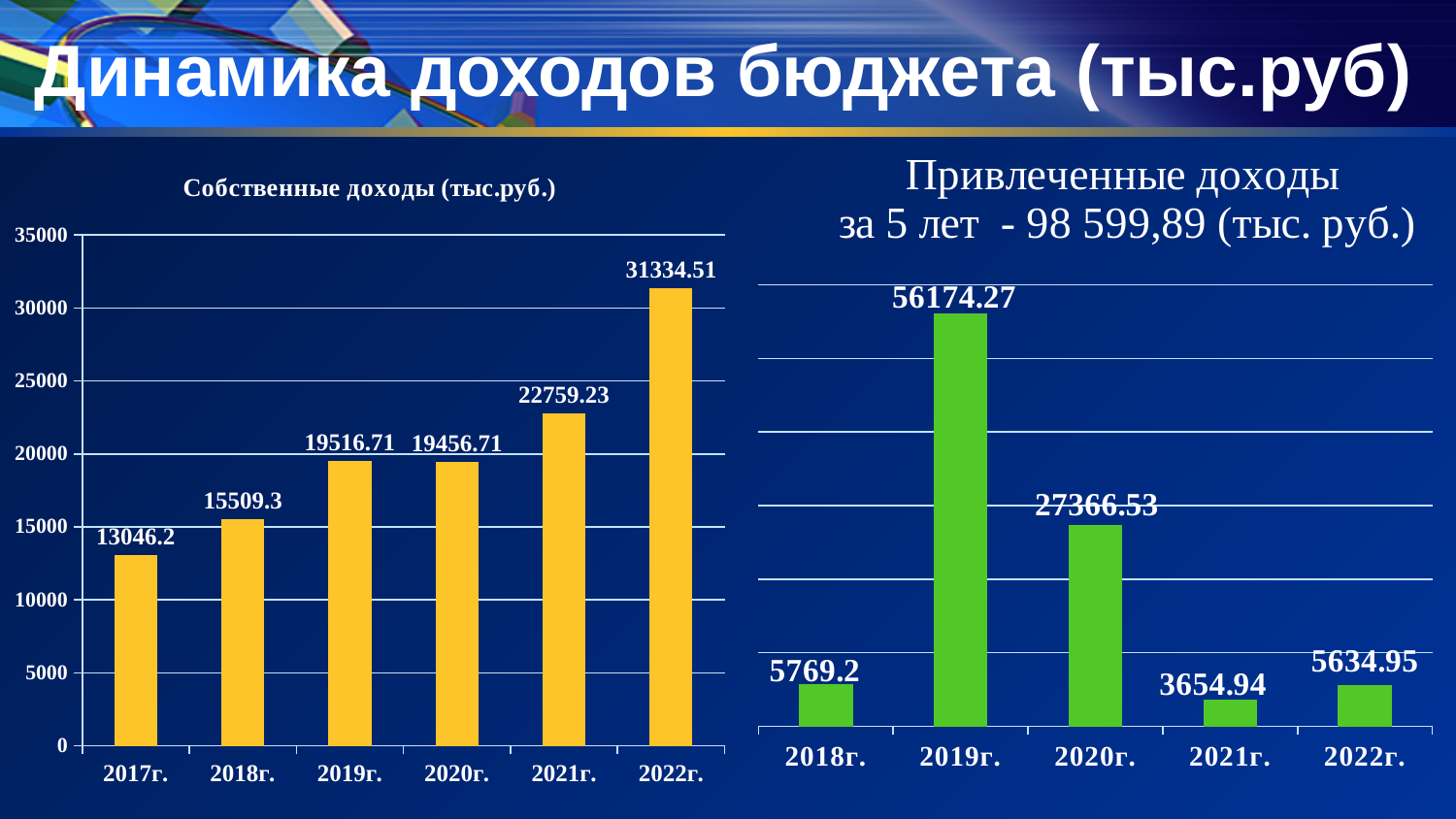
What is the title of the left chart? Собственные доходы (тыс.руб.) On the left chart (Собственные доходы), which year has the highest value? 2022г. On the right chart (Привлеченные доходы), what is the value for 2020г.? 27366.53 On the left chart (Собственные доходы), what is the value for 2017г.? 13046.2 On the right chart (Привлеченные доходы), which is larger: the value for 2018г. or the value for 2022г.? 2018г. On the left chart (Собственные доходы), what is the difference between the values for 2022г. and 2021г.? 8575.28 On the right chart (Привлеченные доходы), what is the value for 2021г.? 3654.94 On the right chart (Привлеченные доходы), which year has the lowest value? 2021г. On the left chart (Собственные доходы), is the value for 2021г. greater or less than 20000? greater How many years are shown on the right chart (Привлеченные доходы)? 5 On the left chart (Собственные доходы), what is the value for 2019г.? 19516.71 What kind of chart is the left chart (Собственные доходы)? bar chart